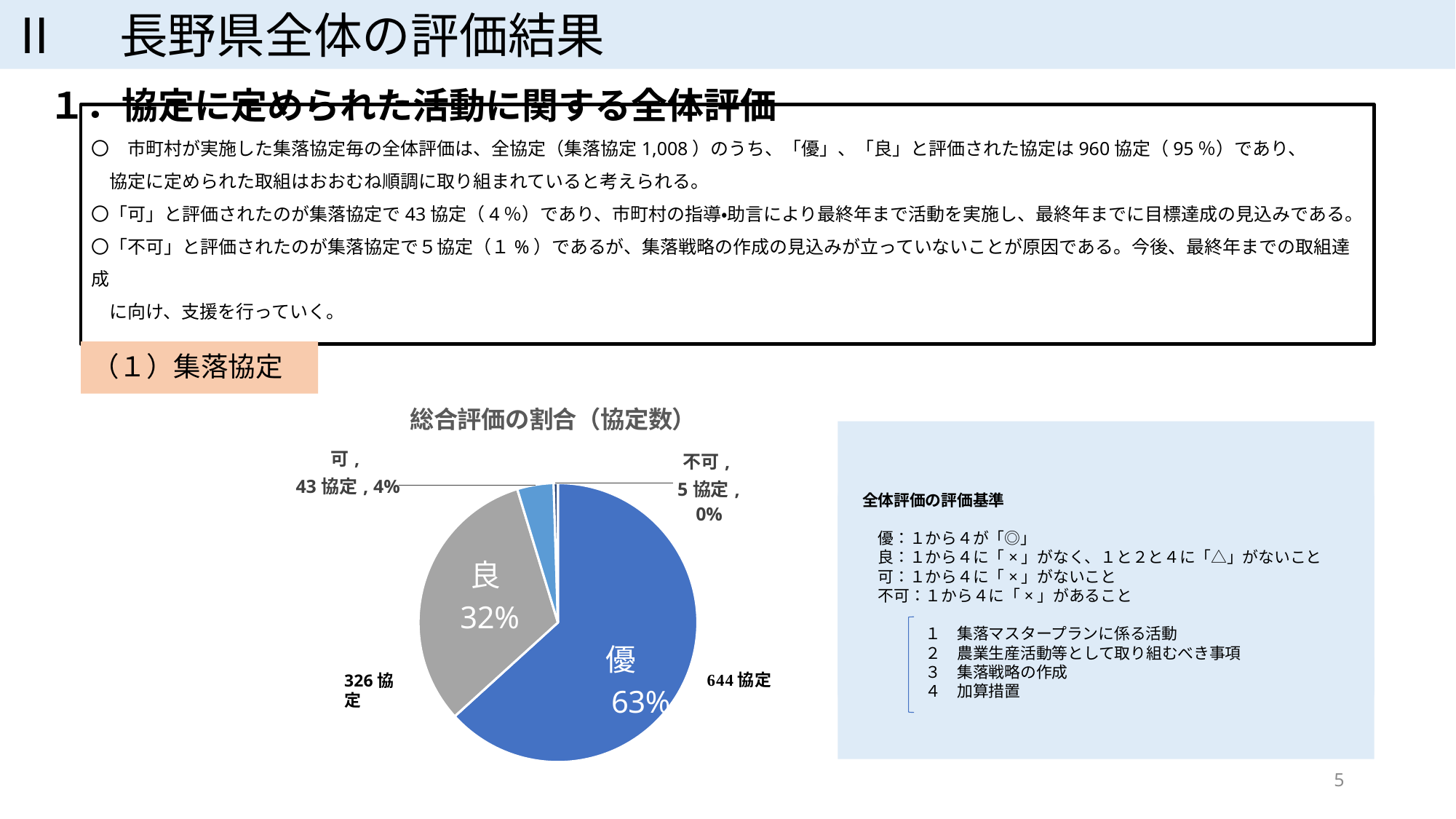
How many 協定 are in the 良 slice of the pie chart? 326 協定 How many 協定 are in the 優 slice of the pie chart? 644 協定 What is the difference in 協定 count between the 優 and 良 slices? 318 What share of the pie does the 良 slice represent? 32% What type of chart is shown on the slide? pie chart Which category has the smallest slice in the pie chart? 不可 How many 協定 are in the 不可 slice of the pie chart? 5 協定 How many slices does the pie chart have? 4 What share of the pie does the 優 slice represent? 63% What is the title of the pie chart? 総合評価の割合（協定数） How many 協定 are in the 可 slice of the pie chart? 43 協定 Which category has the largest slice in the pie chart? 優